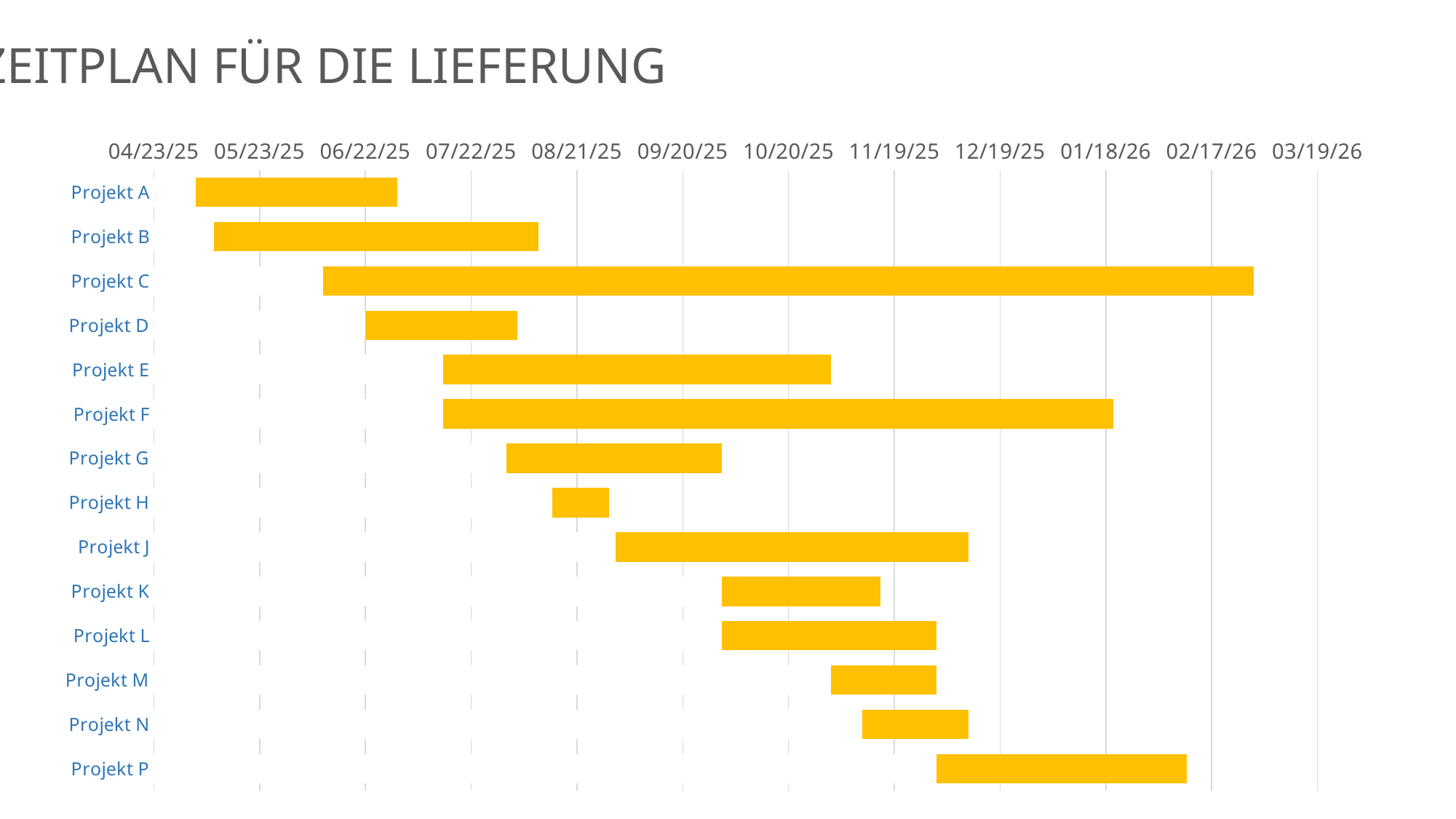
What colour are the bars on the chart? Yellow Which project has the longer bar, Projekt E or Projekt F? Projekt F Which project has the longer bar, Projekt K or Projekt L? Projekt L Which project has the longer bar, Projekt A or Projekt B? Projekt B Does the bar for Projekt P start before or after 11/19/25? after Does the bar for Projekt A end before or after 07/22/25? before Does the bar for Projekt C end before or after 02/17/26? after What kind of chart is shown on the slide? Bar chart (Gantt chart) How many projects are listed on the chart? 14 Which project has the longest bar on the chart? Projekt C Which project has the shortest bar on the chart? Projekt H What is the title of the chart on the slide? ZEITPLAN FÜR DIE LIEFERUNG